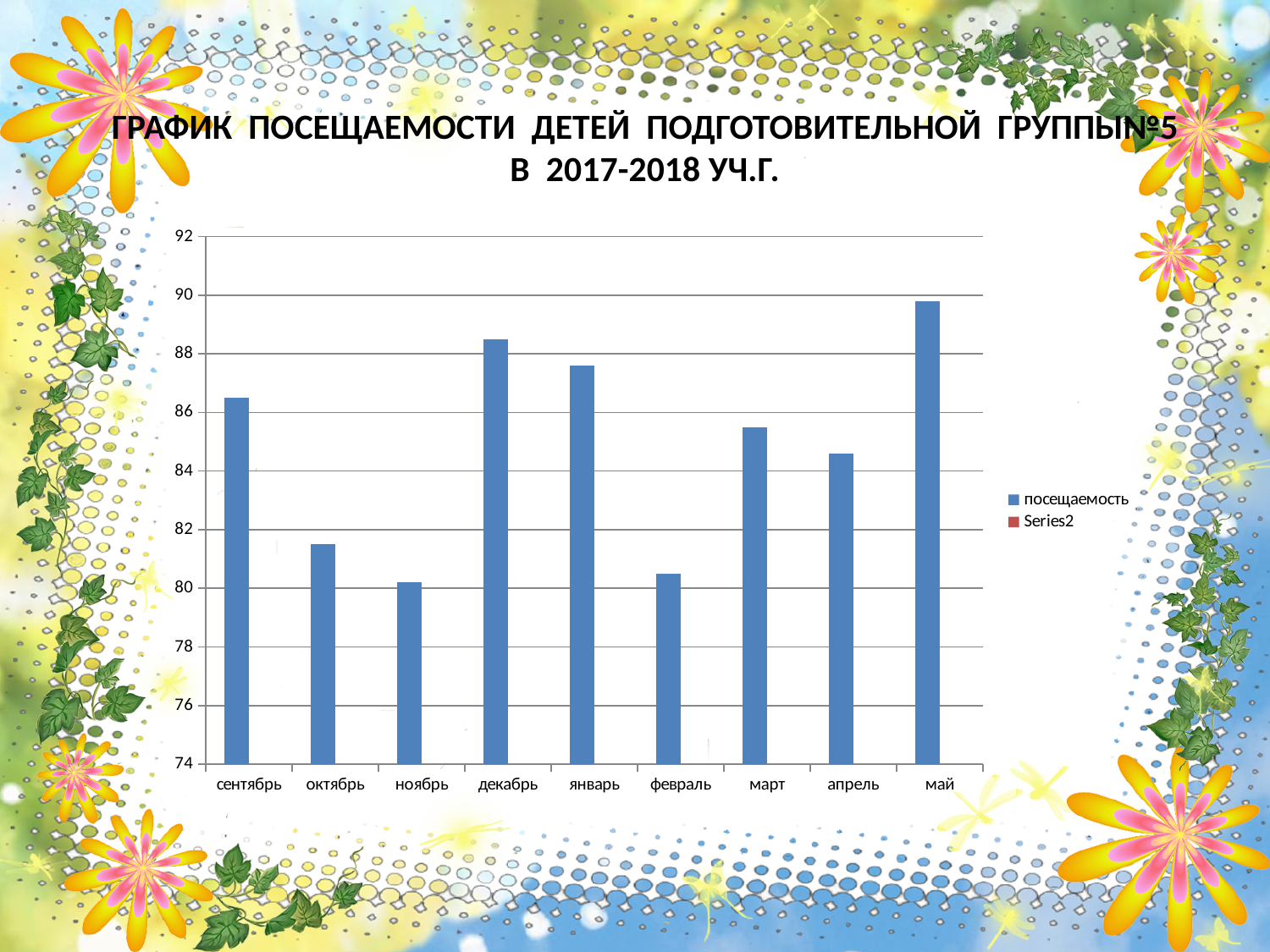
Which is larger, the value for сентябрь or the value for октябрь? сентябрь Which is larger, the value for март or the value for февраль? март Which month has the highest attendance value in the chart? май Do the values rise or fall from сентябрь to ноябрь? fall Is the value for ноябрь greater or less than 82? less How many months are shown on the x axis of the chart? 9 Is the value for февраль greater or less than 82? less How many series does the chart legend list? 2 What is the name of the first series in the chart legend? посещаемость What kind of chart is shown on the slide? bar chart Is the value for май greater or less than 88? greater